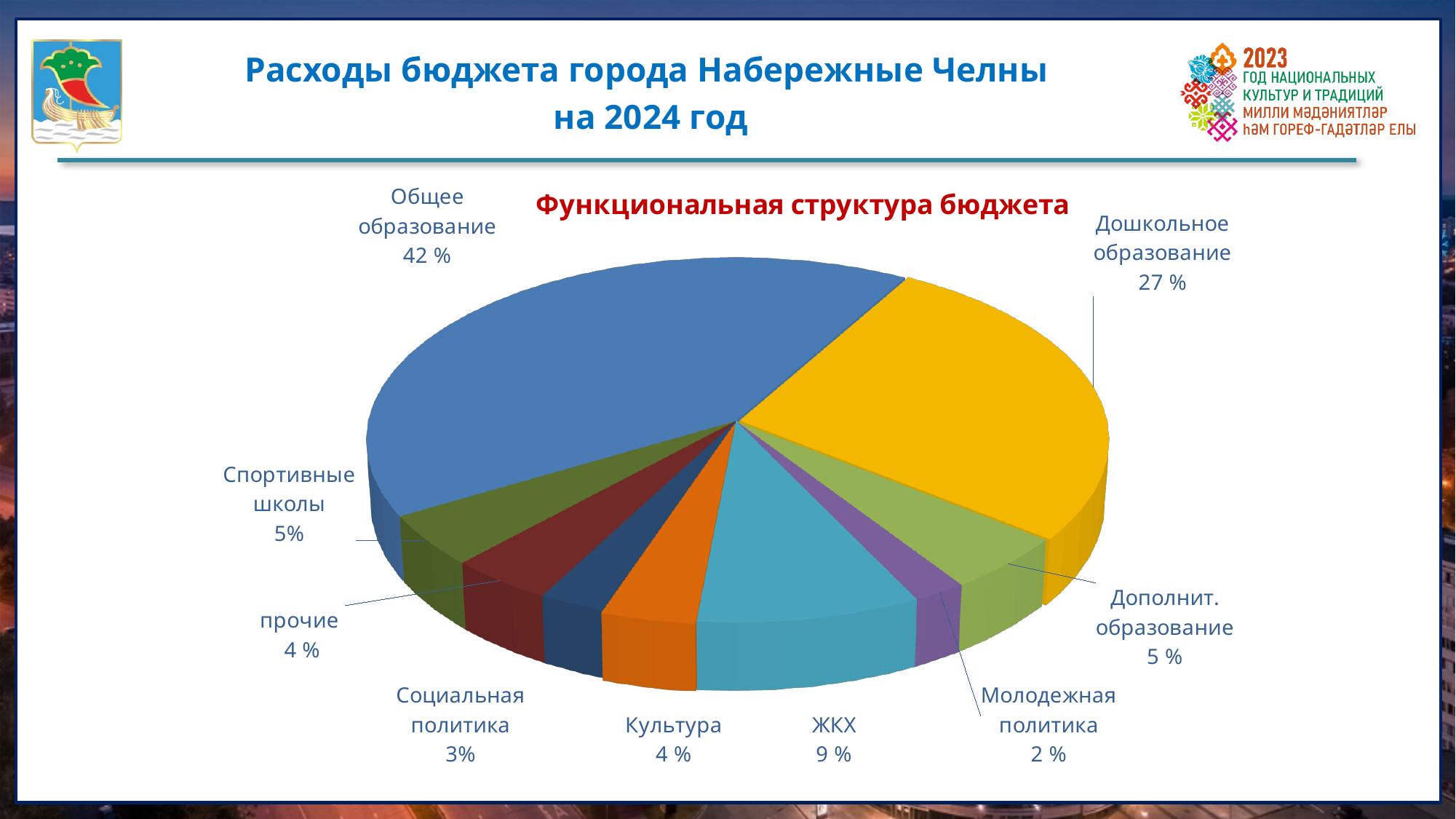
Which has a larger share, ЖКХ or Культура? ЖКХ What share of the budget goes to Социальная политика? 3% Which category has the largest share of the budget? Общее образование What is the title of the chart? Функциональная структура бюджета What kind of chart is shown on the slide? Pie chart How many categories are shown in the pie chart? 9 Which category has the smallest share of the budget? Молодежная политика What share of the budget goes to Дошкольное образование? 27 % What share of the budget goes to Общее образование? 42 % What is the difference in percentage points between Общее образование and Дошкольное образование? 15 What share of the budget goes to Молодежная политика? 2 % What share of the budget goes to ЖКХ? 9 %